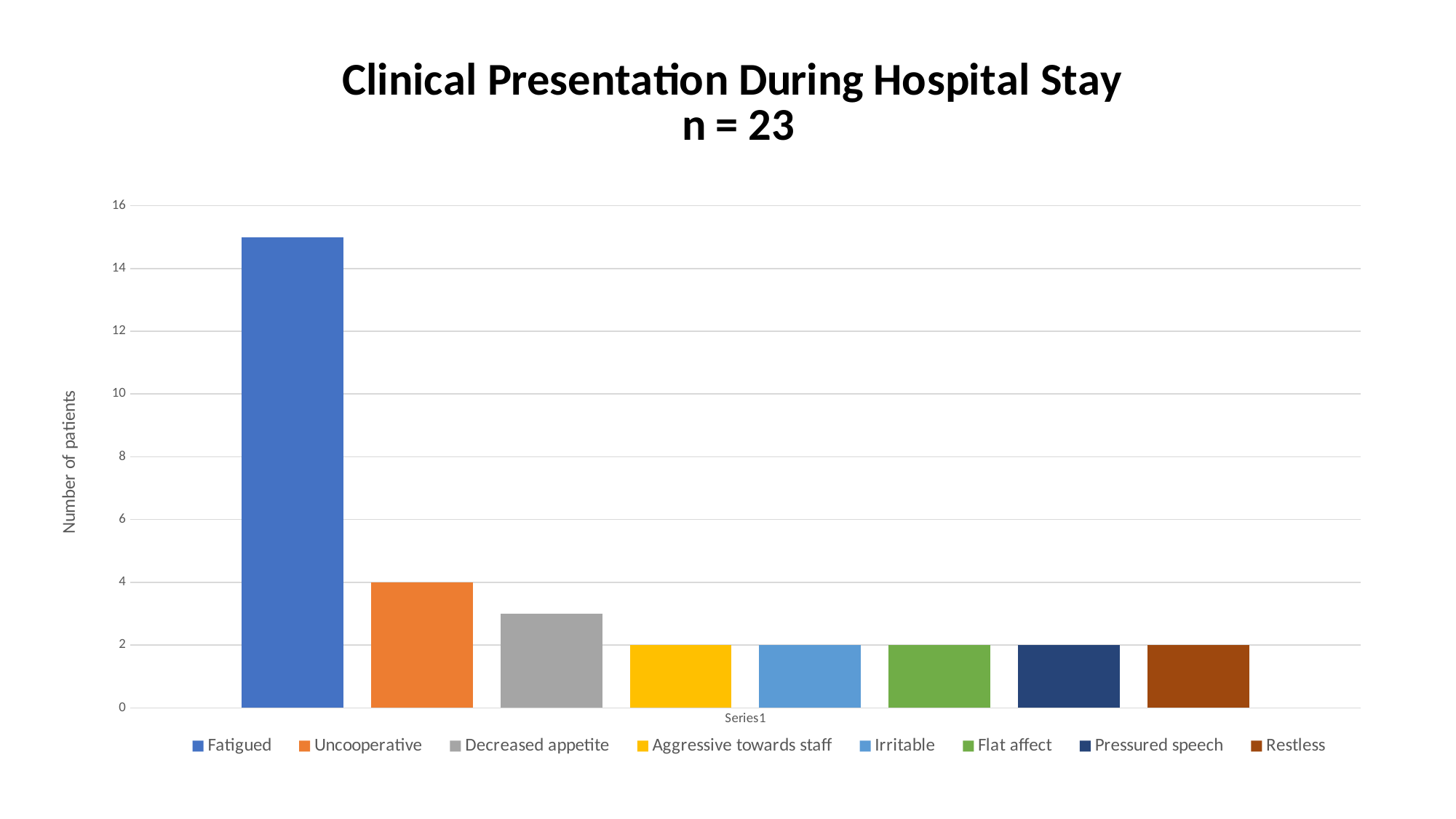
What is the number of patients for Uncooperative? 4 How many series does the legend list? 8 What is the number of patients for Restless? 2 What is the title of the chart? Clinical Presentation During Hospital Stay n = 23 What type of chart is shown on the slide? Bar chart What is the number of patients for Irritable? 2 Is the value for Decreased appetite greater or less than 4? less What is the label of the vertical axis? Number of patients Is the value for Fatigued greater or less than 14? greater Which is larger, the value for Uncooperative or the value for Decreased appetite? Uncooperative How many bars are plotted in the chart? 8 Which clinical presentation has the highest number of patients? Fatigued